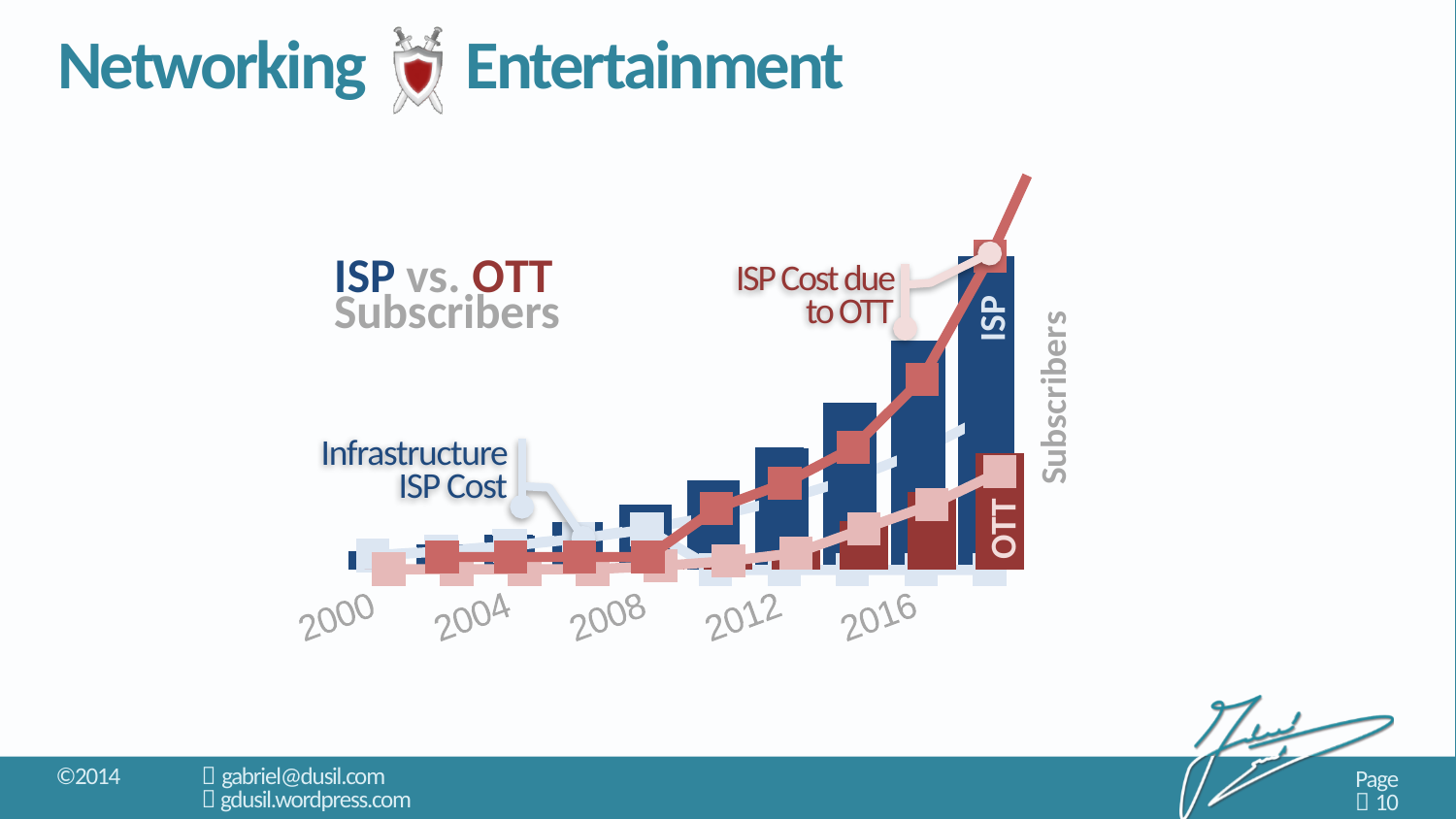
At 2016, which bar is taller, ISP or OTT? ISP What is the last year label on the x axis of the chart? 2016 What label is shown on the vertical axis of the chart? Subscribers How many year labels are shown along the x axis of the chart? 5 Does the 'ISP Cost due to OTT' line rise or fall over the years shown? Rise Which bar series reaches the highest value on the chart, ISP or OTT? ISP Do the ISP subscriber bars rise or fall from 2000 to 2016? Rise What is the title of the chart on the slide? ISP vs. OTT Subscribers How many labelled data series are shown on the chart? 4 What kind of chart is shown on the slide? A combined bar and line chart What is the first year label on the x axis of the chart? 2000